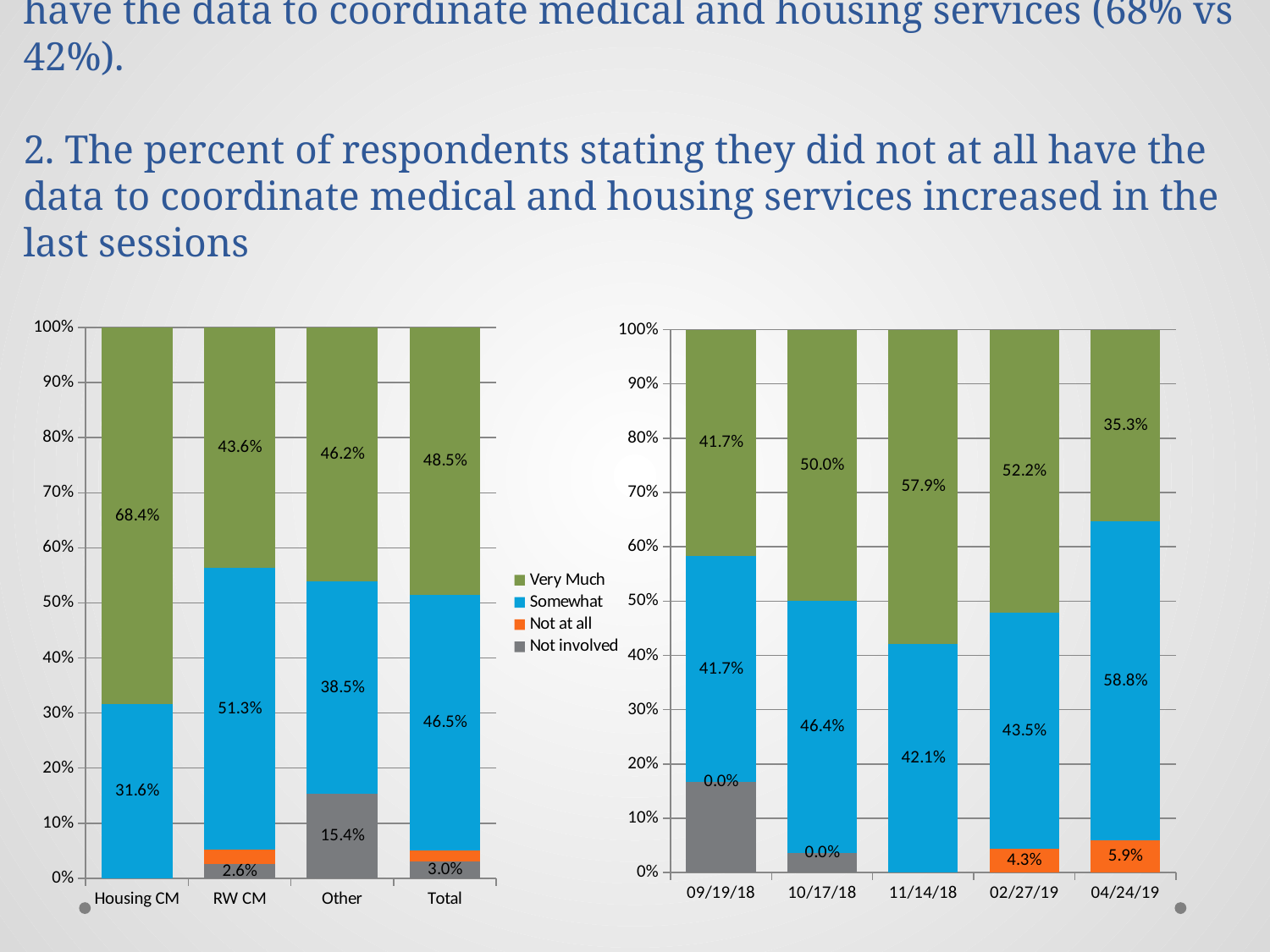
In the right chart, which is larger: the Not at all value for 02/27/19 or for 04/24/19? 04/24/19 In the right chart, what is the Somewhat value for 04/24/19? 58.8% In the left chart, what is the Very Much value for Housing CM? 68.4% In the left chart, how many categories are shown on the x axis? 4 In the right chart, what is the Very Much value for 11/14/18? 57.9% In the left chart, which category has the highest Very Much value? Housing CM In the left chart, what is the Very Much value for Total? 48.5% In the right chart, which date has the lowest Very Much value? 04/24/19 How many series does the legend list? 4 In the left chart, what is the difference between the Very Much values for Housing CM and Other? 22.2% In the left chart, what is the Somewhat value for RW CM? 51.3% What type of chart is the right chart? Stacked bar chart